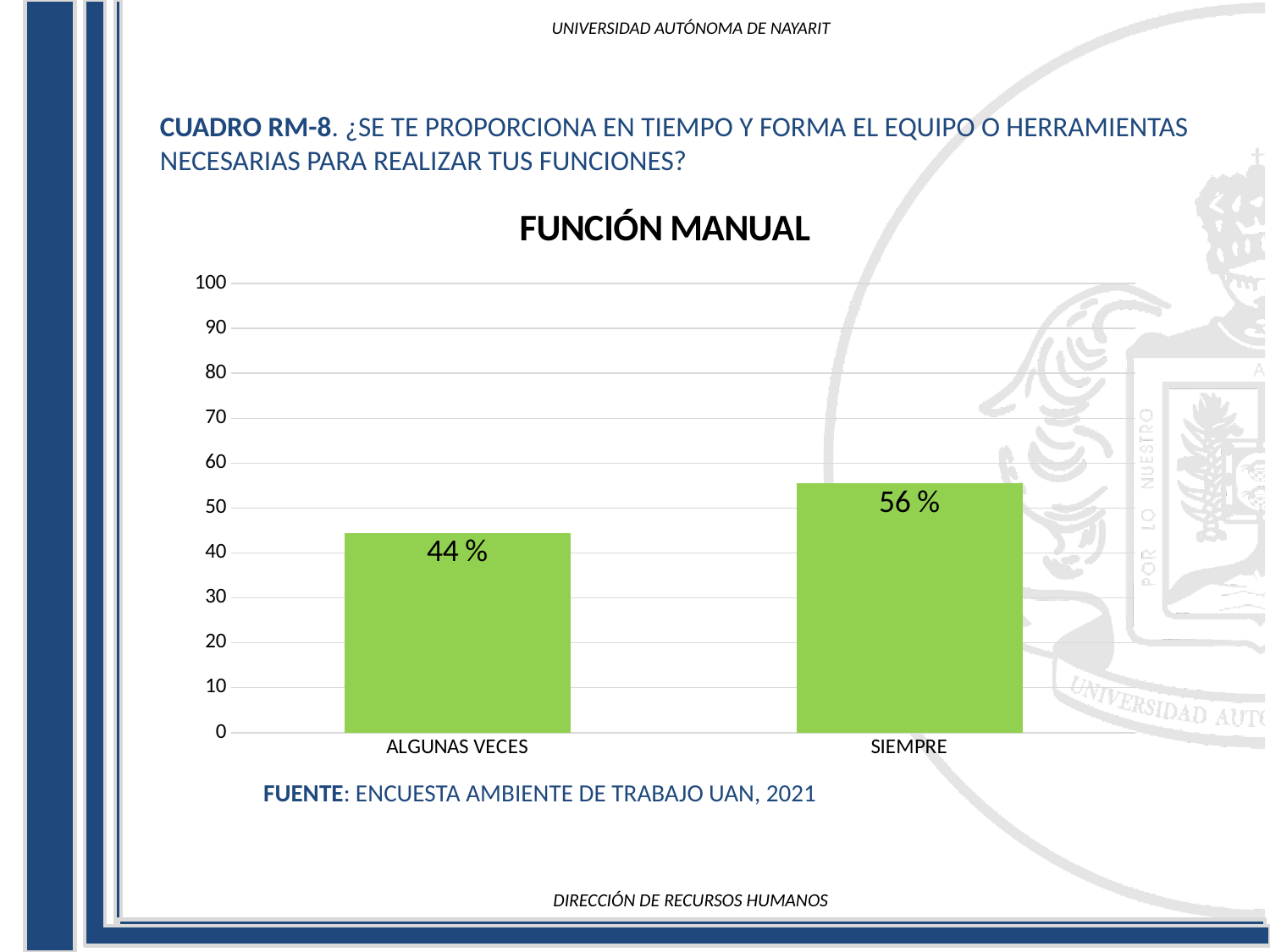
What kind of chart is shown on the slide? bar chart What is the value for ALGUNAS VECES? 44 % How many categories are shown on the x axis? 2 What is the title of the chart? FUNCIÓN MANUAL Which category has the highest value? SIEMPRE Which is larger, the value for ALGUNAS VECES or the value for SIEMPRE? SIEMPRE Is the value for ALGUNAS VECES greater or less than 50? less What is the difference between the values for SIEMPRE and ALGUNAS VECES? 12 % What is the value for SIEMPRE? 56 % What is the maximum value shown on the y axis? 100 Is the value for SIEMPRE greater or less than 50? greater Which category has the lowest value? ALGUNAS VECES